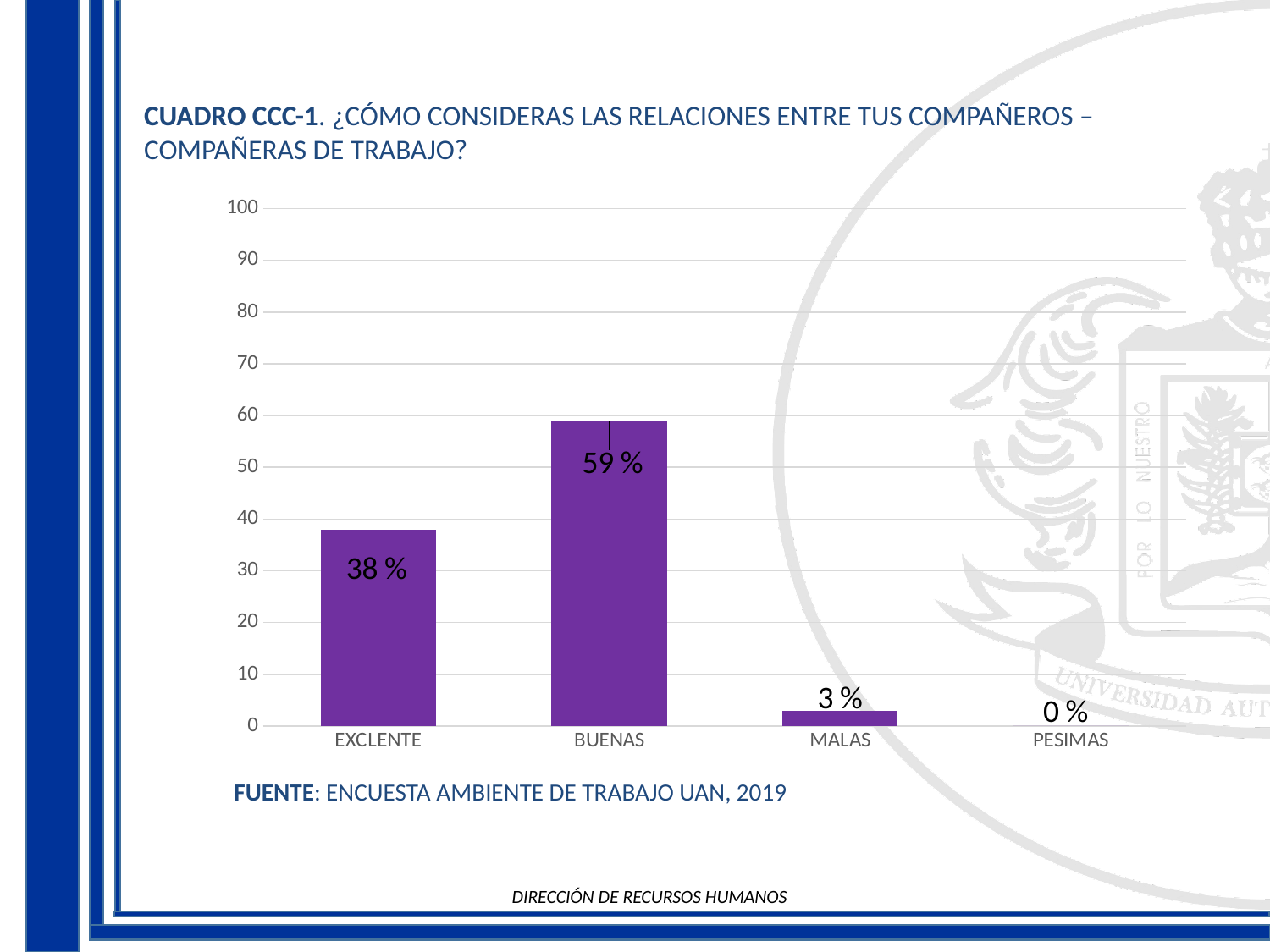
What is the source cited below the chart? ENCUESTA AMBIENTE DE TRABAJO UAN, 2019 What is the value for EXCLENTE? 38 % Which category has the lowest value? PESIMAS What kind of chart is shown on the slide? bar chart What is the value for MALAS? 3 % Which is larger, the value for EXCLENTE or the value for MALAS? EXCLENTE What is the difference between the values for BUENAS and EXCLENTE? 21 % Which category has the highest value? BUENAS Is the value for BUENAS greater or less than 50? greater What is the value for BUENAS? 59 % How many categories are shown on the x axis? 4 What is the value for PESIMAS? 0 %